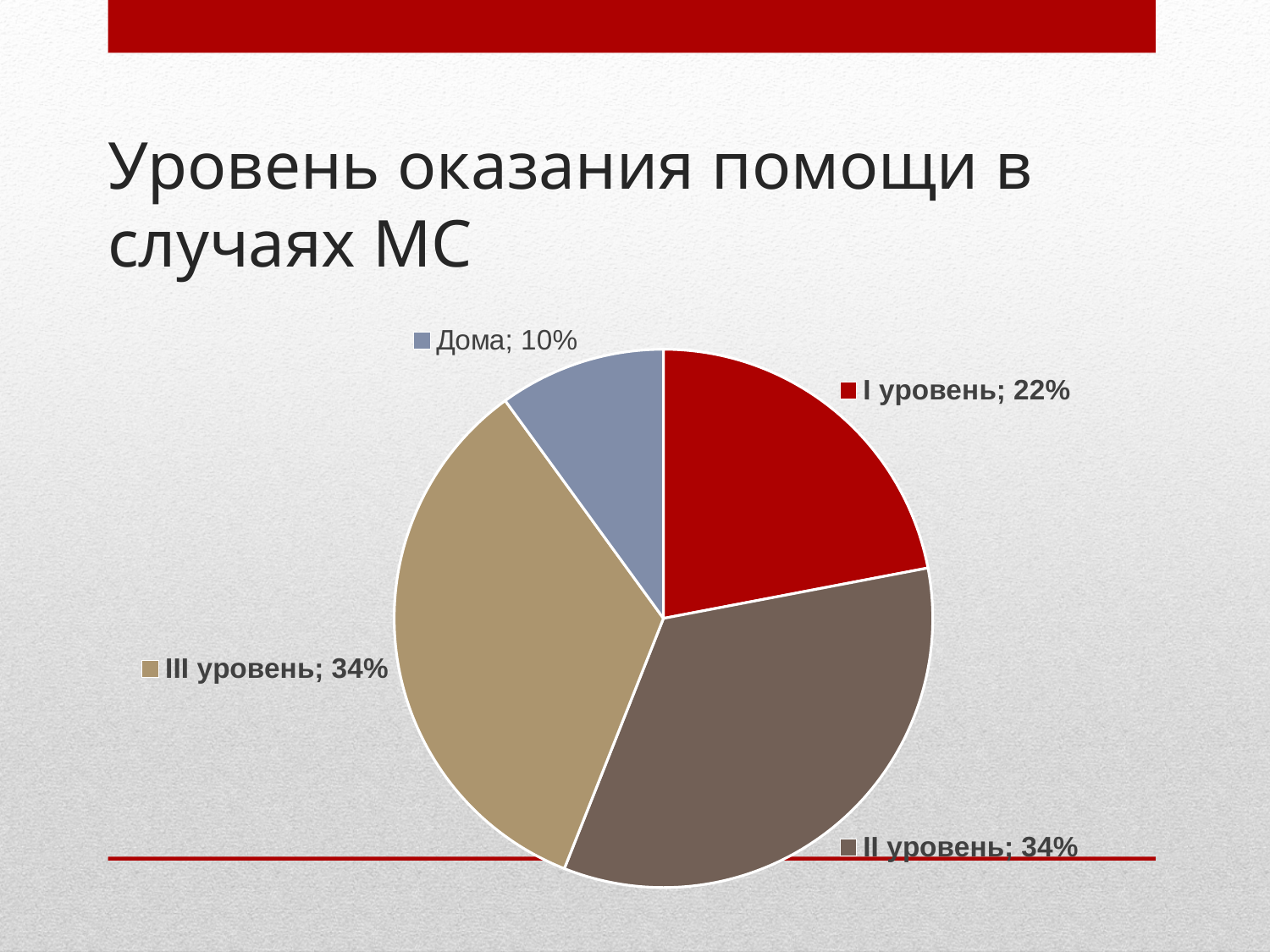
Which is larger, the share for "I уровень" or the share for "Дома"? I уровень What is the difference between the shares of "I уровень" and "Дома"? 12% How many slices does the pie chart have? 4 What is the difference between the shares of "II уровень" and "I уровень"? 12% What is the value shown for "I уровень"? 22% What is the title of the slide containing the chart? Уровень оказания помощи в случаях МС What is the value shown for "II уровень"? 34% What share of the pie does the "Дома" slice represent? 10% What is the value shown for "III уровень"? 34% Which category has the smallest slice of the pie? Дома What kind of chart is shown on the slide? Pie chart What colour is the "I уровень" slice? Red